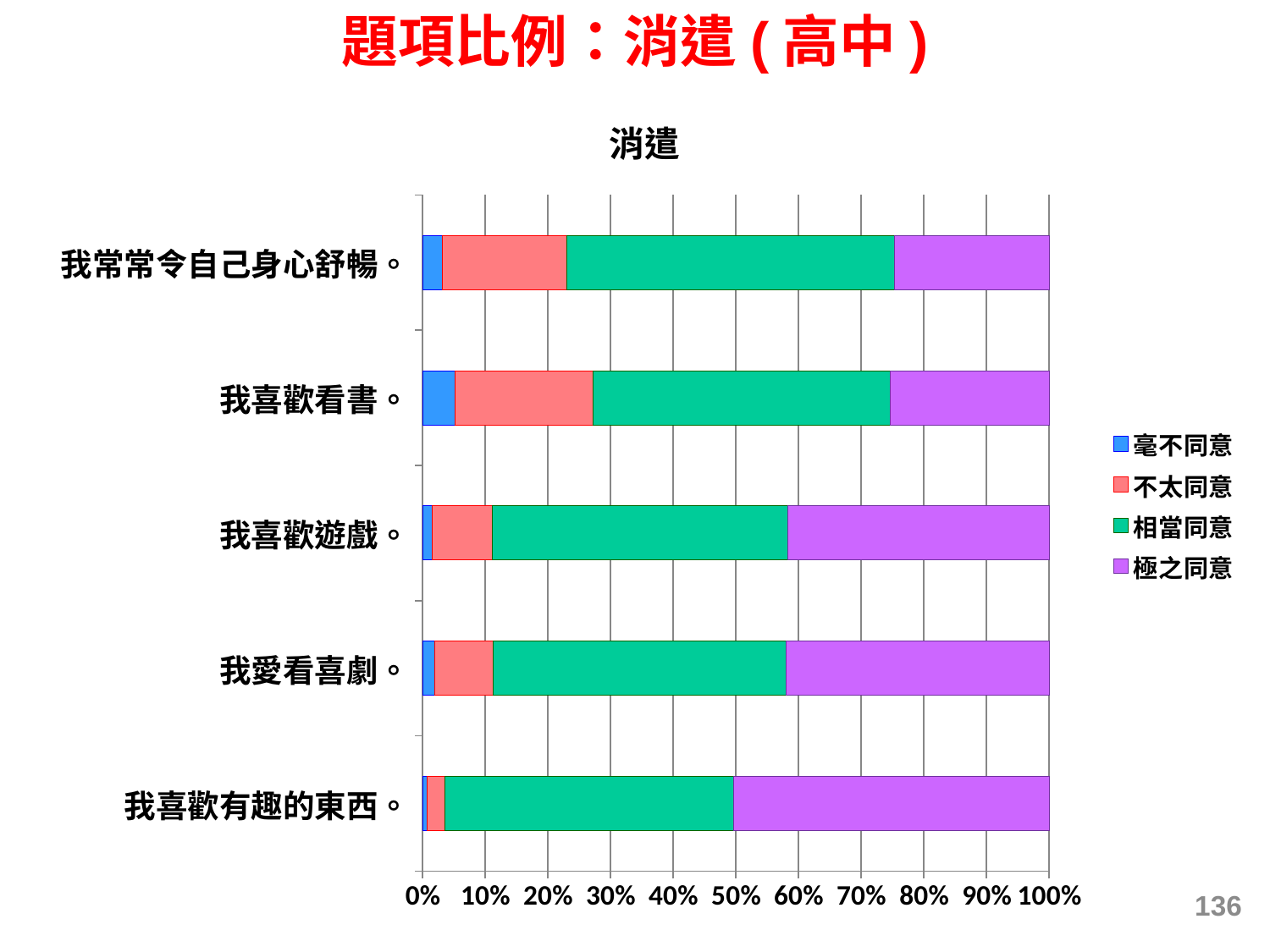
How many categories (statements) are plotted on the chart? 5 Is the 不太同意 value for 我喜歡看書 greater or less than 10%? greater Which statement has the largest 極之同意 segment? 我喜歡有趣的東西 Which statement has the smallest 不太同意 segment? 我喜歡有趣的東西 What kind of chart is shown on the slide? stacked bar chart How many series does the legend list? 4 Which has the larger 極之同意 value: 我喜歡有趣的東西 or 我常常令自己身心舒暢? 我喜歡有趣的東西 Is the 相當同意 value for 我喜歡遊戲 greater or less than 40%? greater Is the 極之同意 value for 我常常令自己身心舒暢 greater or less than 30%? less What is the title of the chart? 消遣 Which legend entry is shown in purple? 極之同意